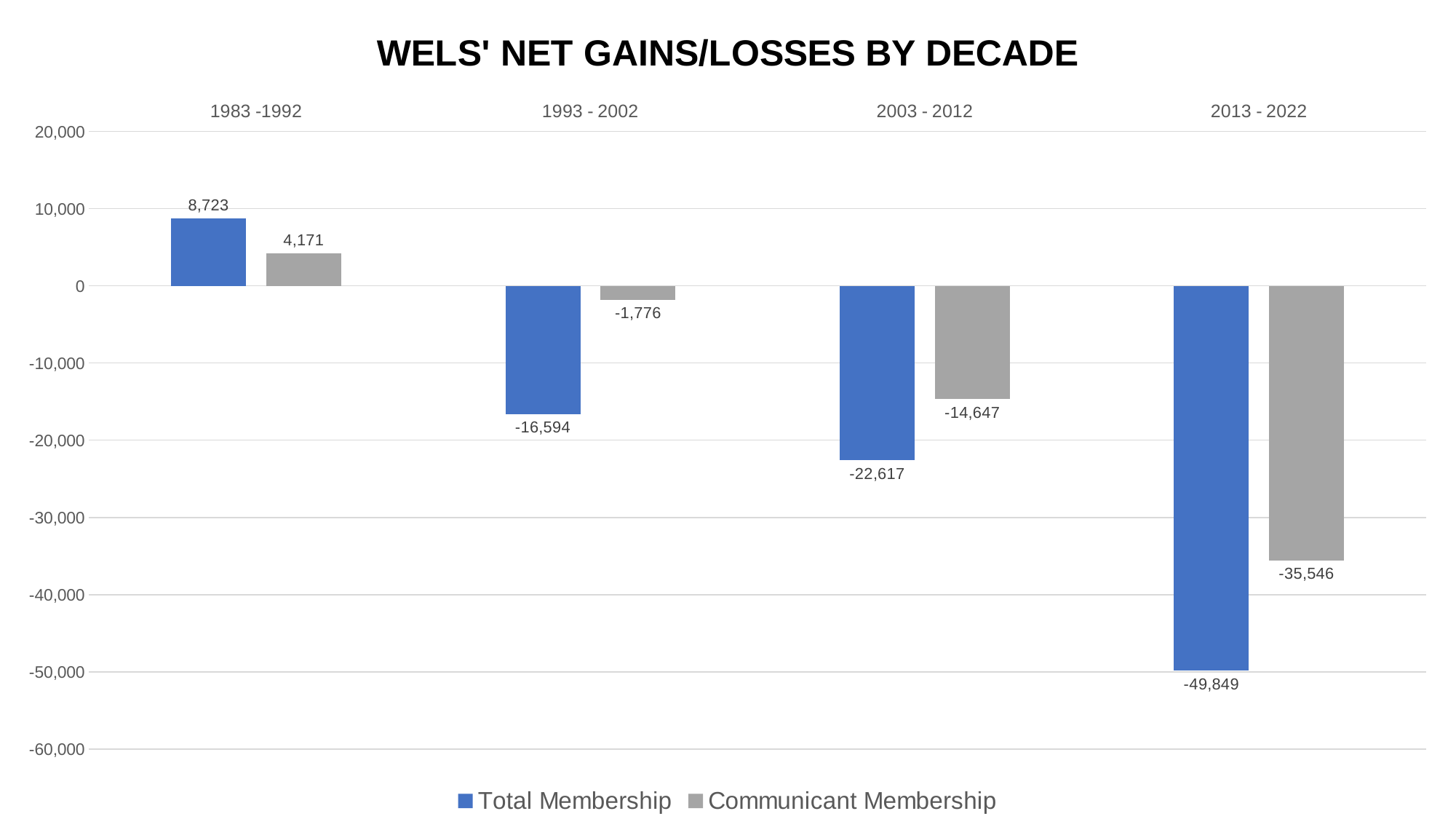
What kind of chart is shown? bar chart What is the Total Membership net gain/loss for 1983 -1992? 8,723 What is the difference between the Total Membership and Communicant Membership values for 2003 - 2012? 7,970 Which decade has the lowest Total Membership value? 2013 - 2022 Which is larger, the Total Membership value for 1993 - 2002 or the Total Membership value for 2003 - 2012? 1993 - 2002 Do the Total Membership values rise or fall across the decades from 1983 -1992 to 2013 - 2022? fall How many series does the legend list? 2 How many decades are shown on the x axis? 4 Which decade has the highest Communicant Membership value? 1983 -1992 Is the Total Membership value for 2013 - 2022 greater or less than -40,000? less What is the Communicant Membership value for 1993 - 2002? -1,776 What is the Communicant Membership net gain/loss for 2013 - 2022? -35,546